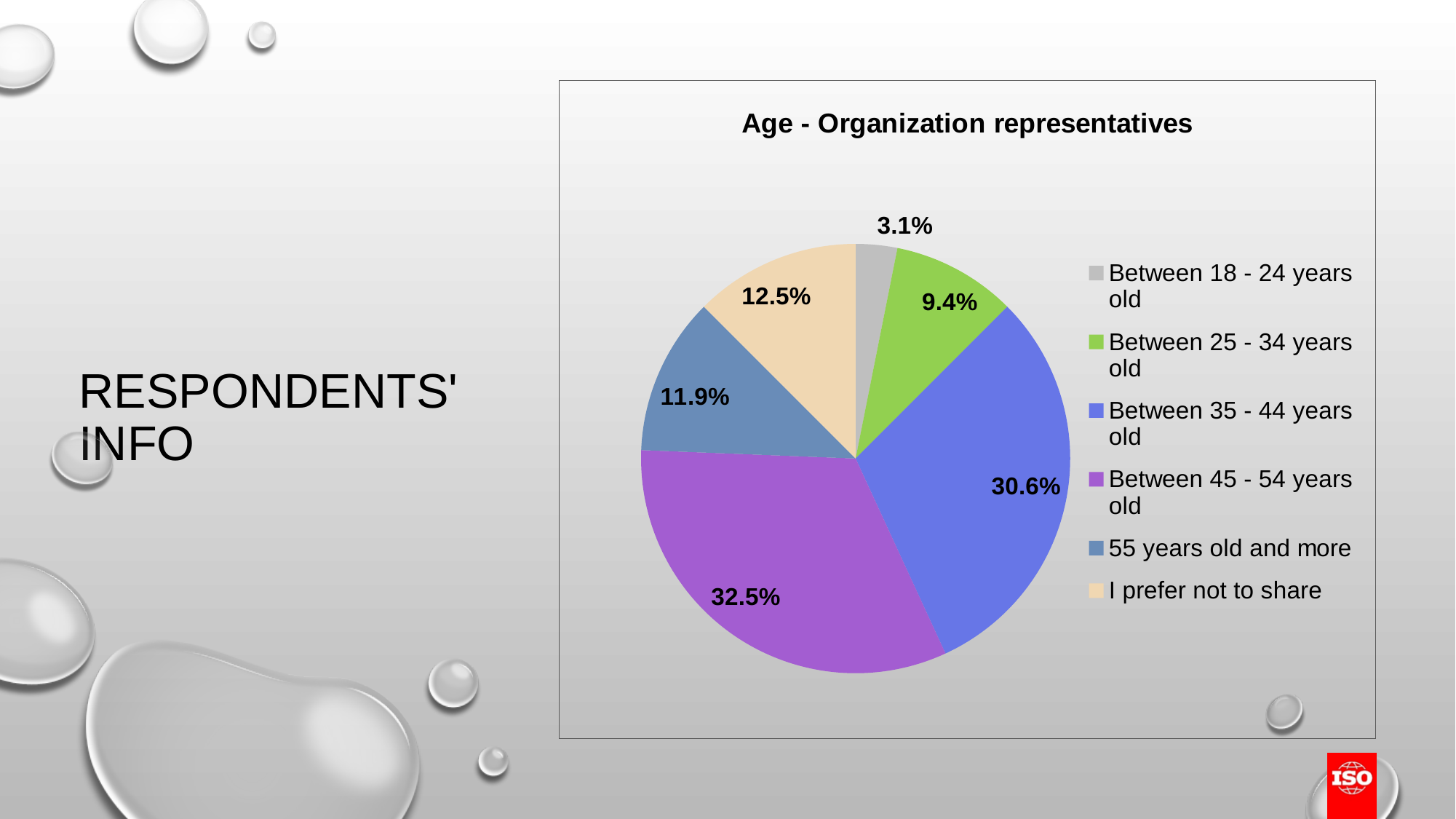
What is the difference between the share for 'Between 25 - 34 years old' and 'Between 18 - 24 years old'? 6.3% Which is larger: the share for 'I prefer not to share' or the share for '55 years old and more'? I prefer not to share Which age group has the smallest share of the pie? Between 18 - 24 years old What share of organization representatives are between 45 - 54 years old? 32.5% How many categories does the pie chart have? 6 What kind of chart is shown on the slide? pie chart What share of organization representatives are between 35 - 44 years old? 30.6% What share of organization representatives chose 'I prefer not to share'? 12.5% Which age group has the largest share of the pie? Between 45 - 54 years old What is the title of the chart? Age - Organization representatives What share of organization representatives are between 18 - 24 years old? 3.1% What share of organization representatives are 55 years old and more? 11.9%